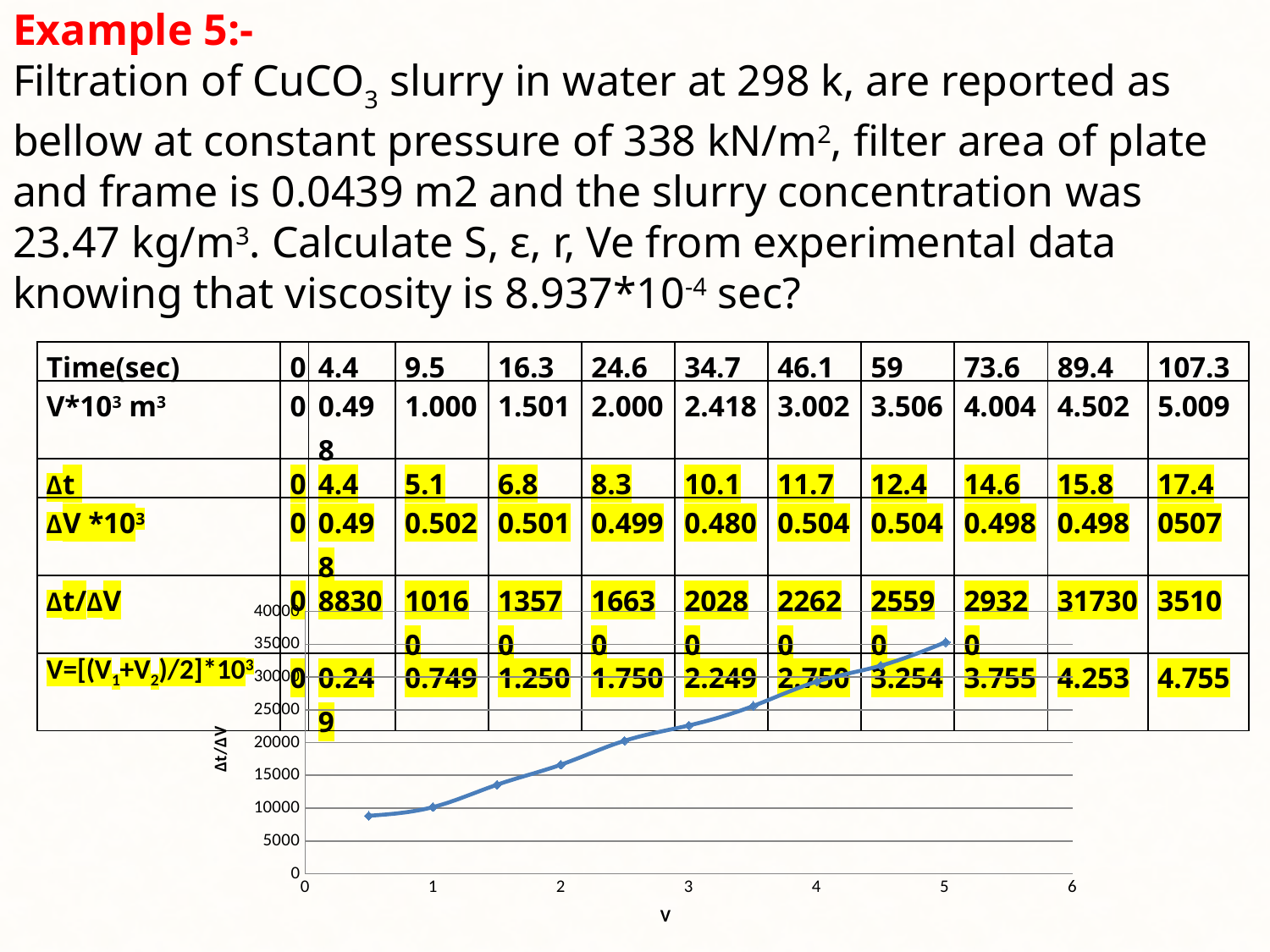
Is the value of Δt/ΔV at V = 5 greater or less than 30000? greater Which is larger, the Δt/ΔV value at V = 4 or at V = 2? V = 4 Is the value of Δt/ΔV at V = 3 greater or less than 20000? greater Is the value of Δt/ΔV at V = 4 greater or less than 25000? greater What is the title of the x axis of the chart? V How many data points are plotted on the line? 10 Which plotted point has the highest Δt/ΔV value, the leftmost or the rightmost? the rightmost What is the title of the y axis of the chart? Δt/ΔV Do the plotted values rise or fall as V increases along the x axis? rise What kind of chart is shown on the slide? line chart